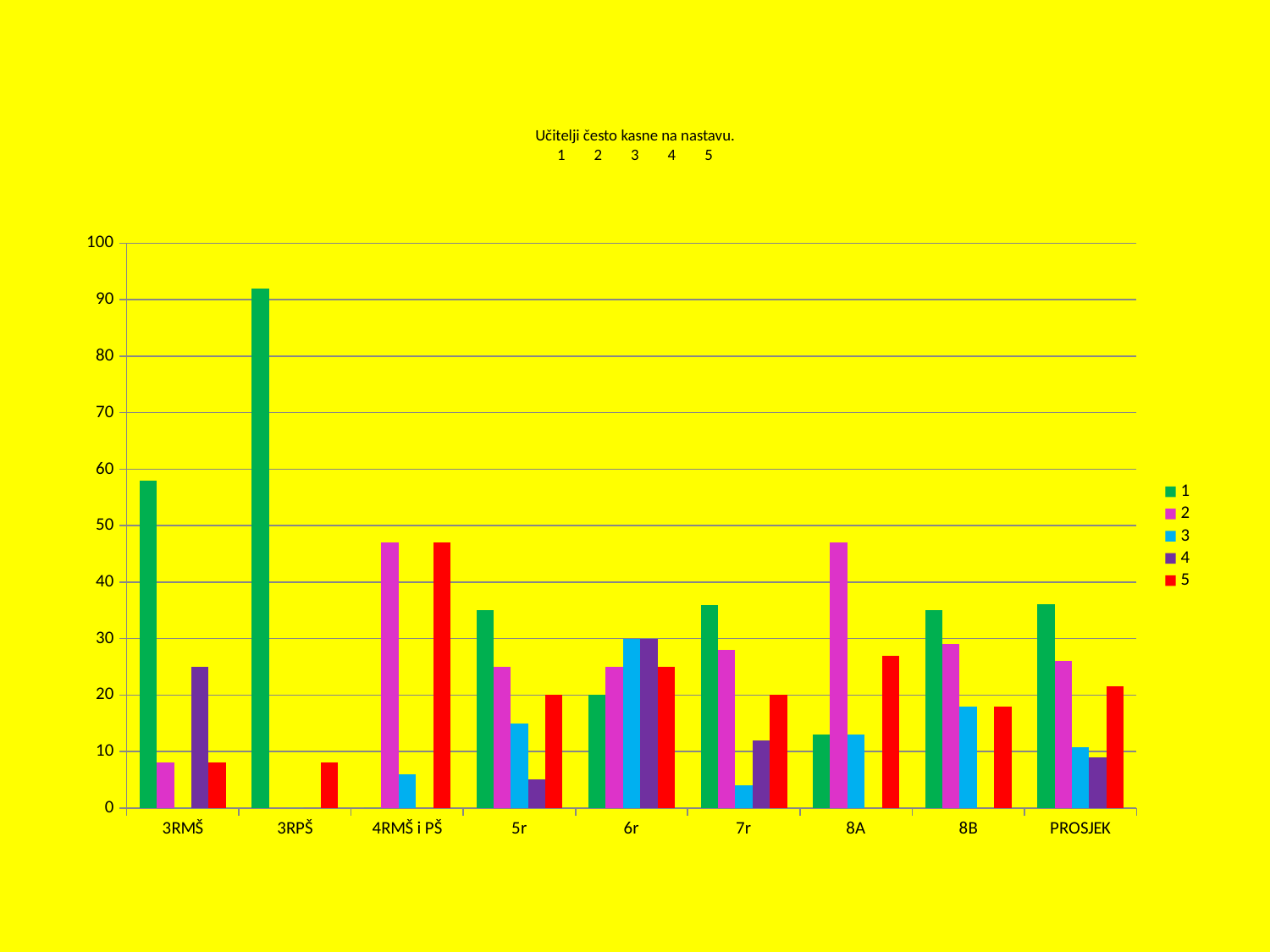
In 8A, which is larger: series 1 or series 2? series 2 What is the title of the chart? Učitelji često kasne na nastavu. Is the value for series 2 in 4RMŠ i PŠ greater or less than 40? greater In 7r, which is larger: series 1 or series 2? series 1 Is the value for series 1 in 3RMŠ greater or less than 50? greater Which series has the highest value in 5r? 1 Which category has the highest value for series 1? 3RPŠ How many categories are shown on the x axis? 9 How many series does the legend list? 5 What kind of chart is shown on the slide? bar chart Is the value for series 1 in 3RPŠ greater or less than 80? greater